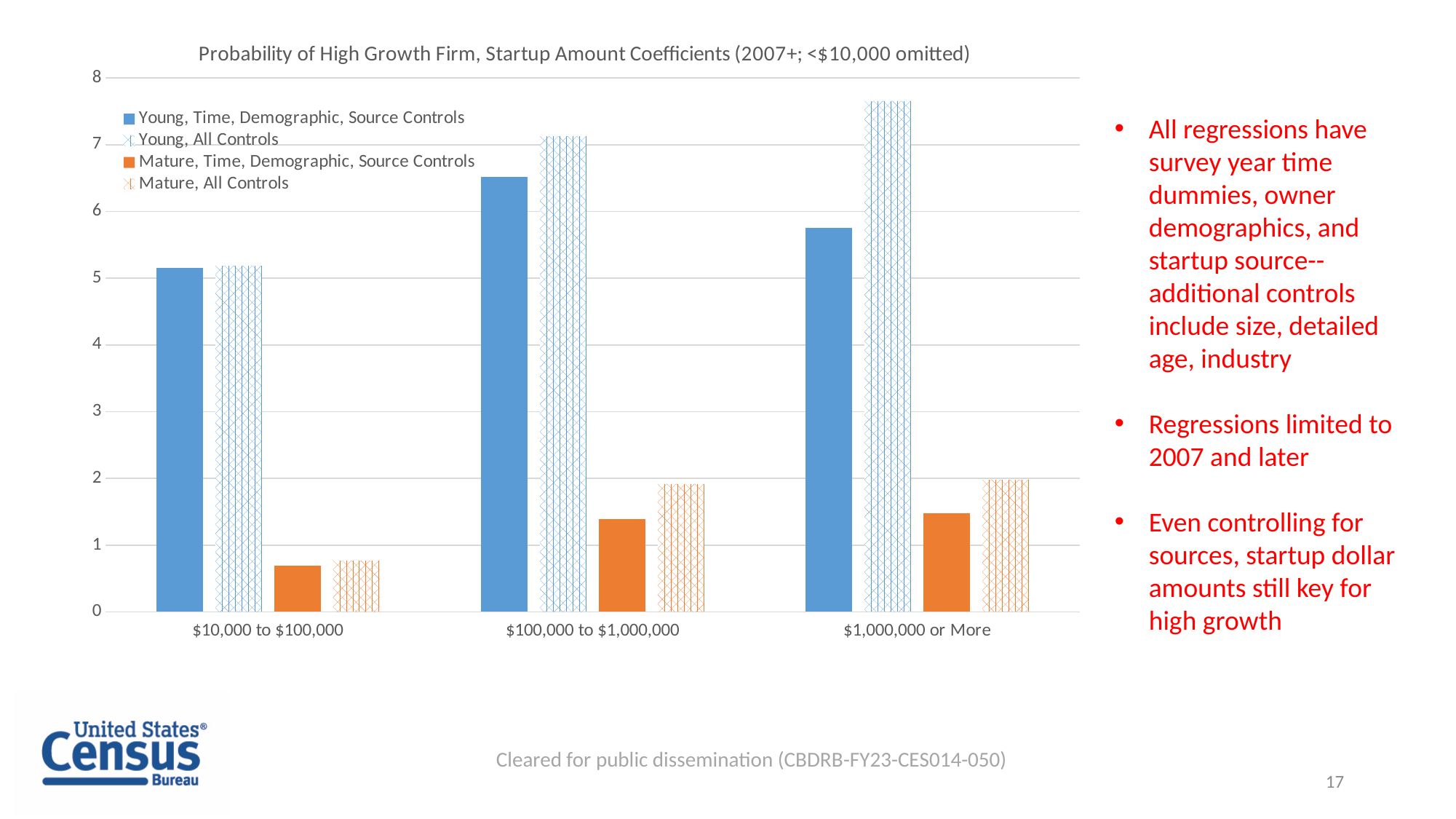
What kind of chart is shown on the slide? Bar chart At $1,000,000 or More, which is larger: Young, All Controls or Young, Time, Demographic, Source Controls? Young, All Controls Which bar is the tallest in the chart? Young, All Controls at $1,000,000 or More Is the value for Mature, Time, Demographic, Source Controls at $10,000 to $100,000 greater or less than 1? less How many series does the legend list? 4 Do the values for Young, All Controls rise or fall as the startup amount increases along the x axis? Rise Is the value for Young, All Controls at $1,000,000 or More greater or less than 7? greater Which bar is the shortest in the chart? Mature, Time, Demographic, Source Controls at $10,000 to $100,000 Is the value for Young, Time, Demographic, Source Controls at $1,000,000 or More greater or less than 5? greater How many startup amount categories are shown on the x axis? 3 What is the title of the chart? Probability of High Growth Firm, Startup Amount Coefficients (2007+; <$10,000 omitted)